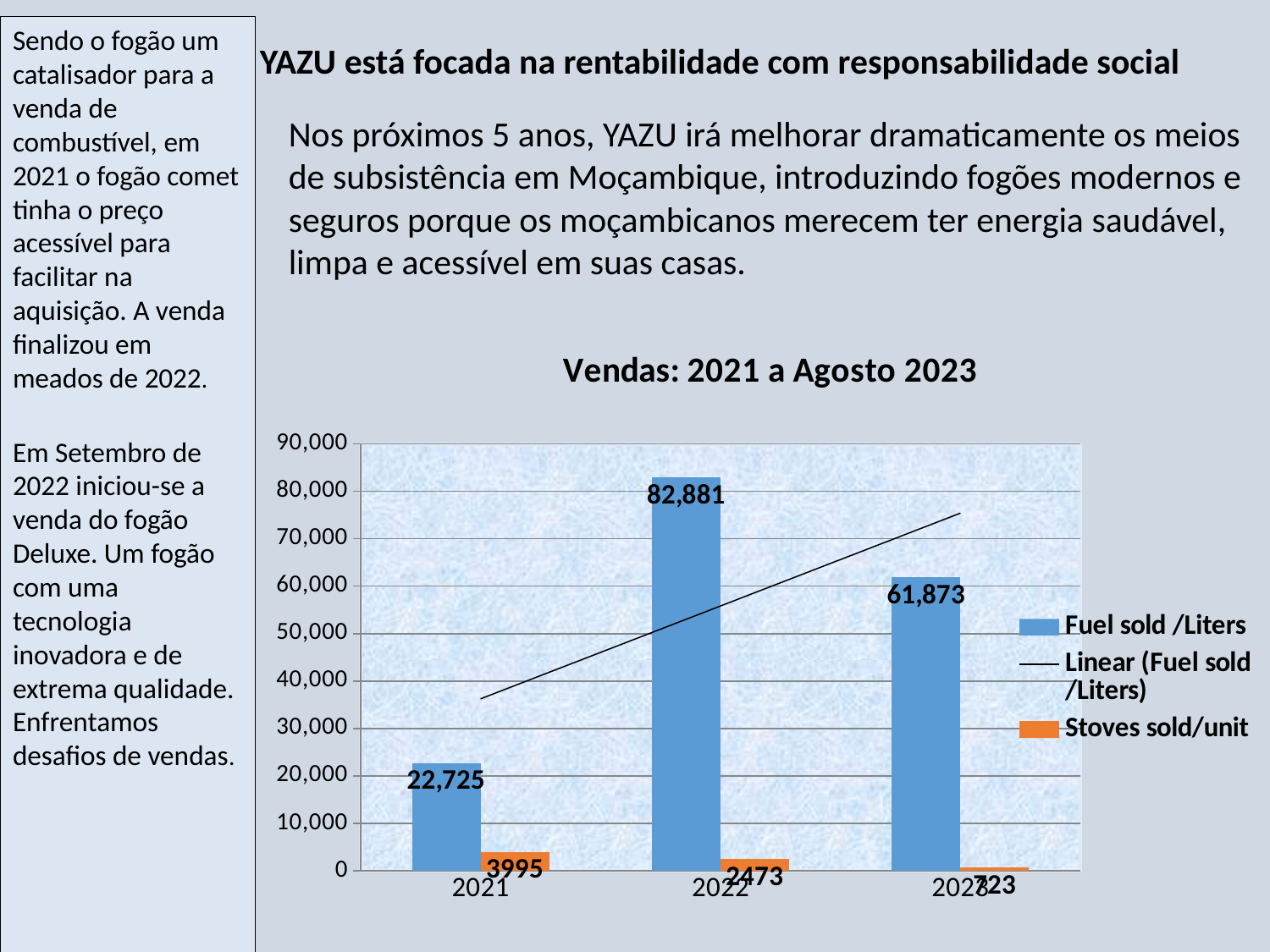
How many Stoves sold/unit are shown for 2021? 3995 How many entries does the chart legend list? 3 Which year has the lowest Fuel sold /Liters? 2021 Is the Fuel sold /Liters value for 2023 greater or less than 60,000? greater What is the difference in Fuel sold /Liters between 2022 and 2023? 21,008 Which year has more Fuel sold /Liters, 2021 or 2023? 2023 What is the value of Fuel sold /Liters for 2022? 82,881 What is the value of Fuel sold /Liters for 2023? 61,873 How many years are shown on the x axis of the chart? 3 Which year has the highest Fuel sold /Liters? 2022 What type of chart is used to show the sales data? bar chart What is the value of Fuel sold /Liters for 2021? 22,725